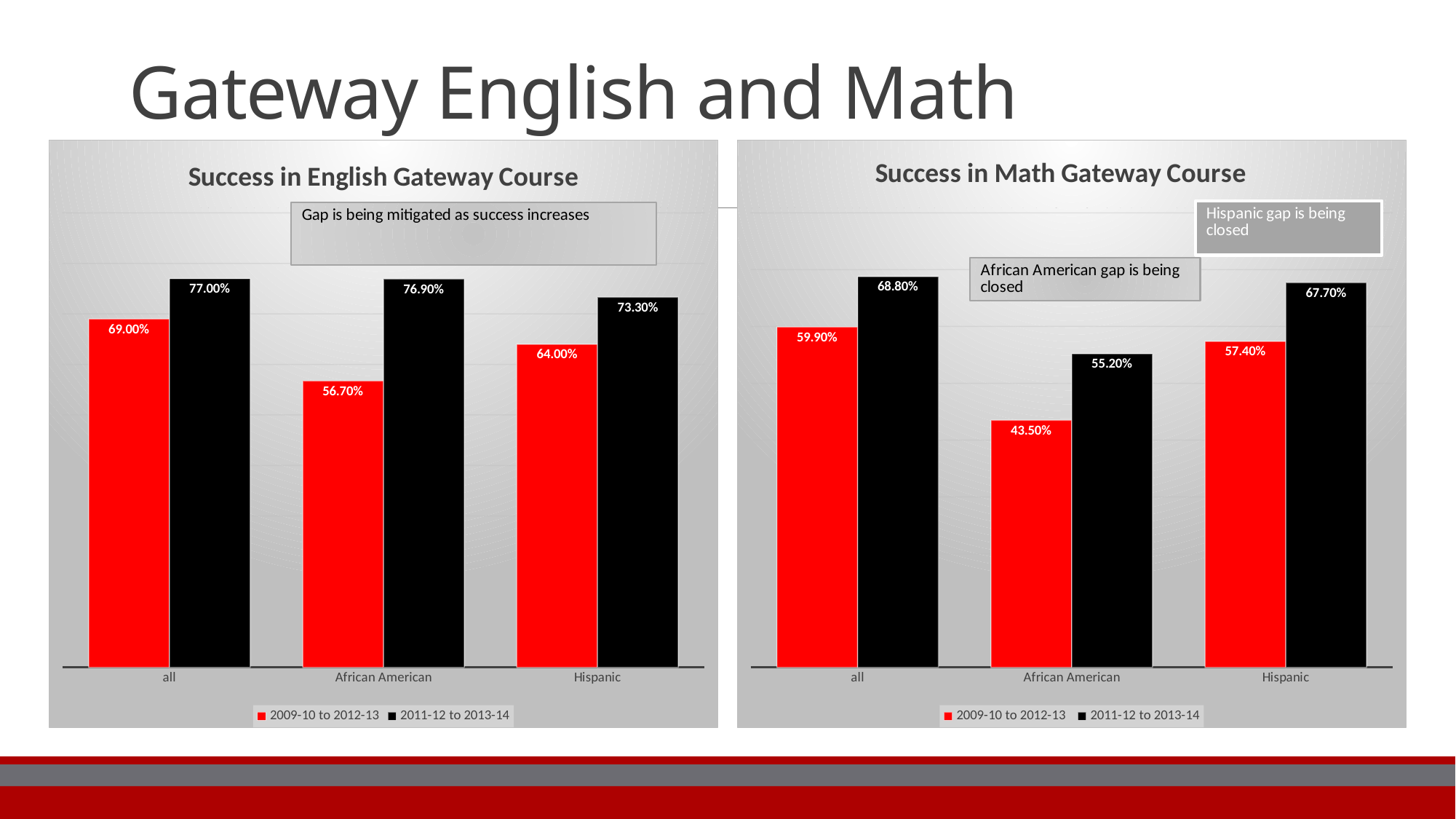
How many categories are shown on the x axis of the 'Success in English Gateway Course' chart? 3 In the 'Success in English Gateway Course' chart, which category has the highest value in the 2011-12 to 2013-14 series? all What is the title of the chart on the right side of the slide? Success in Math Gateway Course In the 'Success in Math Gateway Course' chart, which category has the lowest value in the 2009-10 to 2012-13 series? African American In the 'Success in Math Gateway Course' chart, what is the difference between the 2011-12 to 2013-14 and 2009-10 to 2012-13 values for all? 8.90% In the 'Success in English Gateway Course' chart, what is the value for African American in the 2009-10 to 2012-13 series? 56.70% In the 'Success in English Gateway Course' chart, what is the difference between the 2011-12 to 2013-14 and 2009-10 to 2012-13 values for African American? 20.20% How many series does the legend of the 'Success in Math Gateway Course' chart list? 2 In the 'Success in Math Gateway Course' chart, which is larger: the 2009-10 to 2012-13 value for Hispanic or the 2011-12 to 2013-14 value for African American? 2009-10 to 2012-13 value for Hispanic In the 'Success in English Gateway Course' chart, which colour represents the 2011-12 to 2013-14 series? Black In the 'Success in Math Gateway Course' chart, what is the value for Hispanic in the 2011-12 to 2013-14 series? 67.70% What kind of chart is the 'Success in English Gateway Course' chart? Bar chart